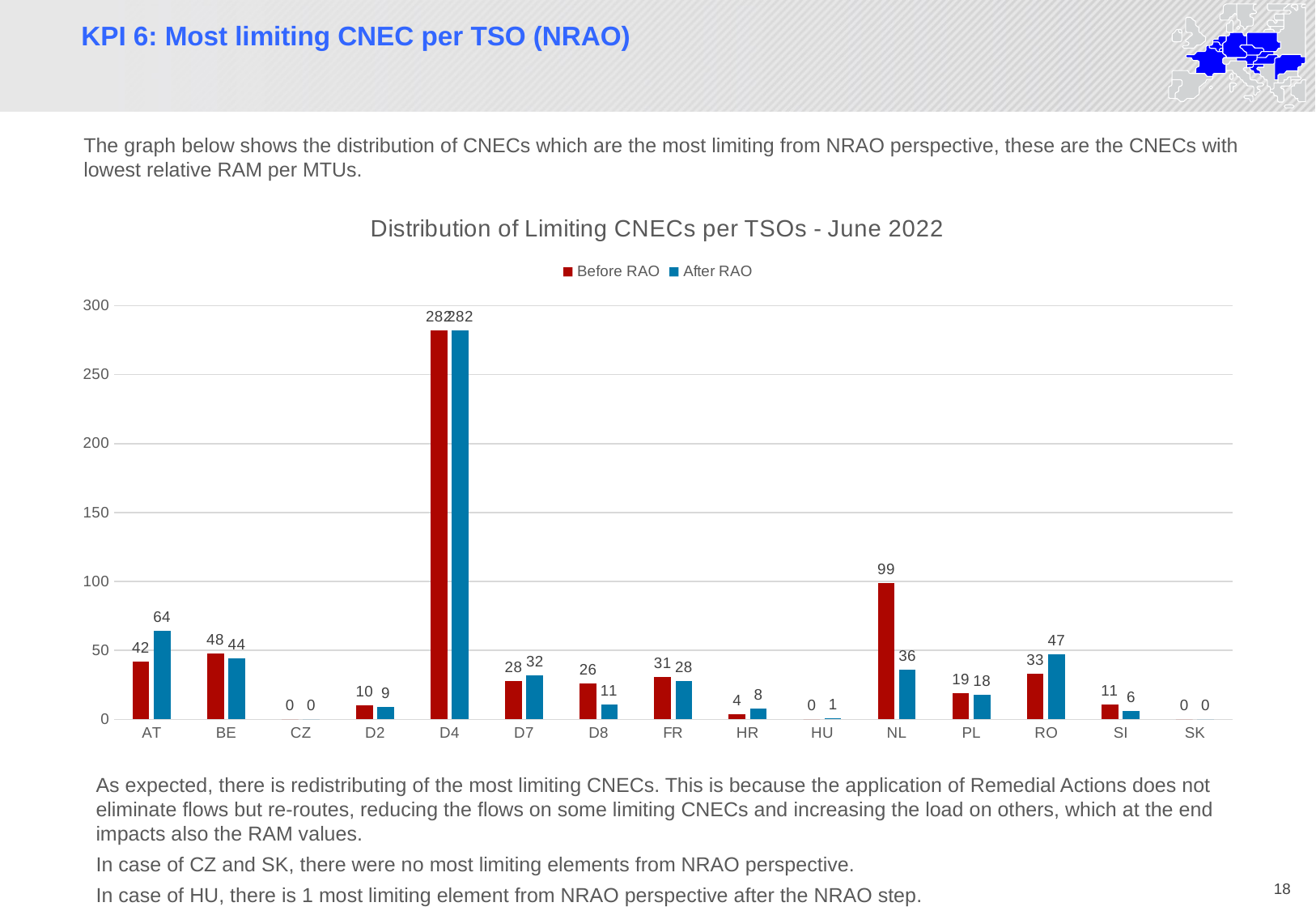
What is the Before RAO value for NL? 99 How many TSO categories are shown on the x axis? 15 What is the difference between the After RAO and Before RAO values for RO? 14 What is the After RAO value for D8? 11 What is the title of the chart? Distribution of Limiting CNECs per TSOs - June 2022 Which TSO has the highest Before RAO value? D4 For AT, which is larger: the Before RAO value or the After RAO value? After RAO What is the After RAO value for AT? 64 What kind of chart is shown on the slide? Bar chart What is the difference between the Before RAO and After RAO values for NL? 63 Which TSO has the highest After RAO value? D4 How many series does the legend list? 2